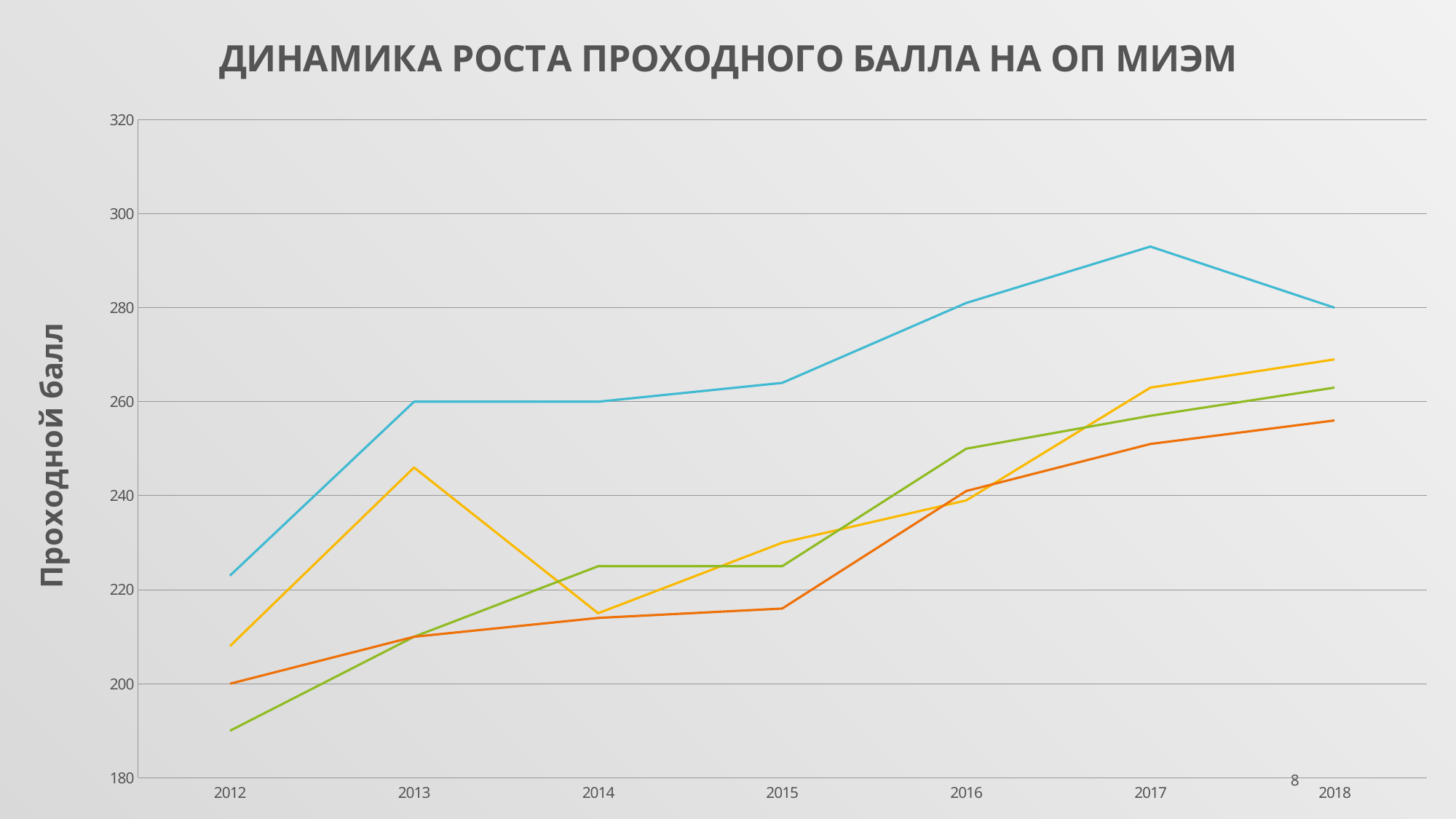
What is the value of the blue line in 2013? 260 In which year does the green line have its lowest value? 2012 How many years are shown along the x axis? 7 What is the value of the blue line in 2018? 280 Is the value of the blue line in 2017 greater or less than 280? greater What is the value of the orange line in 2012? 200 What is the label of the vertical axis? Проходной балл What is the title of the chart? ДИНАМИКА РОСТА ПРОХОДНОГО БАЛЛА НА ОП МИЭМ What kind of chart is shown on the slide? line chart Is the value of the green line in 2012 greater or less than 200? less In which year does the blue line reach its highest value? 2017 Which line has the higher value in 2018, the blue line or the orange line? the blue line